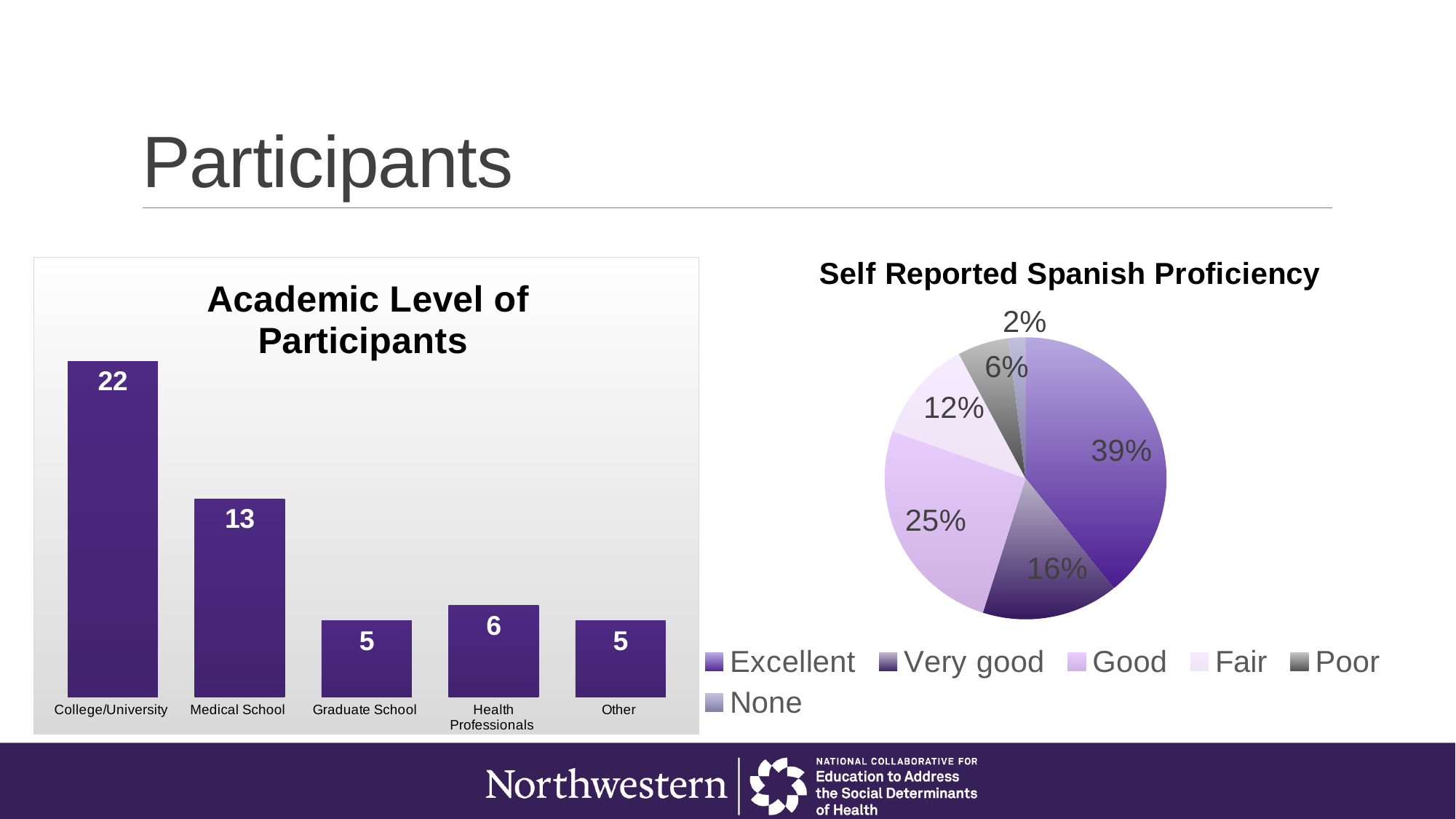
In the Academic Level of Participants chart, what is the difference between College/University and Medical School? 9 In the Self Reported Spanish Proficiency chart, what percentage reported Good proficiency? 25% In the Academic Level of Participants chart, which category has the highest value? College/University In the Academic Level of Participants chart, how many participants are from College/University? 22 What kind of chart is the Academic Level of Participants chart? Bar chart In the Academic Level of Participants chart, what is the value for Medical School? 13 How many categories are shown in the Academic Level of Participants chart? 5 In the Self Reported Spanish Proficiency chart, what share of participants reported Excellent proficiency? 39% How many categories does the legend of the Self Reported Spanish Proficiency chart list? 6 What kind of chart is the Self Reported Spanish Proficiency chart? Pie chart In the Self Reported Spanish Proficiency chart, which category has the smallest share? None In the Academic Level of Participants chart, which is larger, Health Professionals or Graduate School? Health Professionals